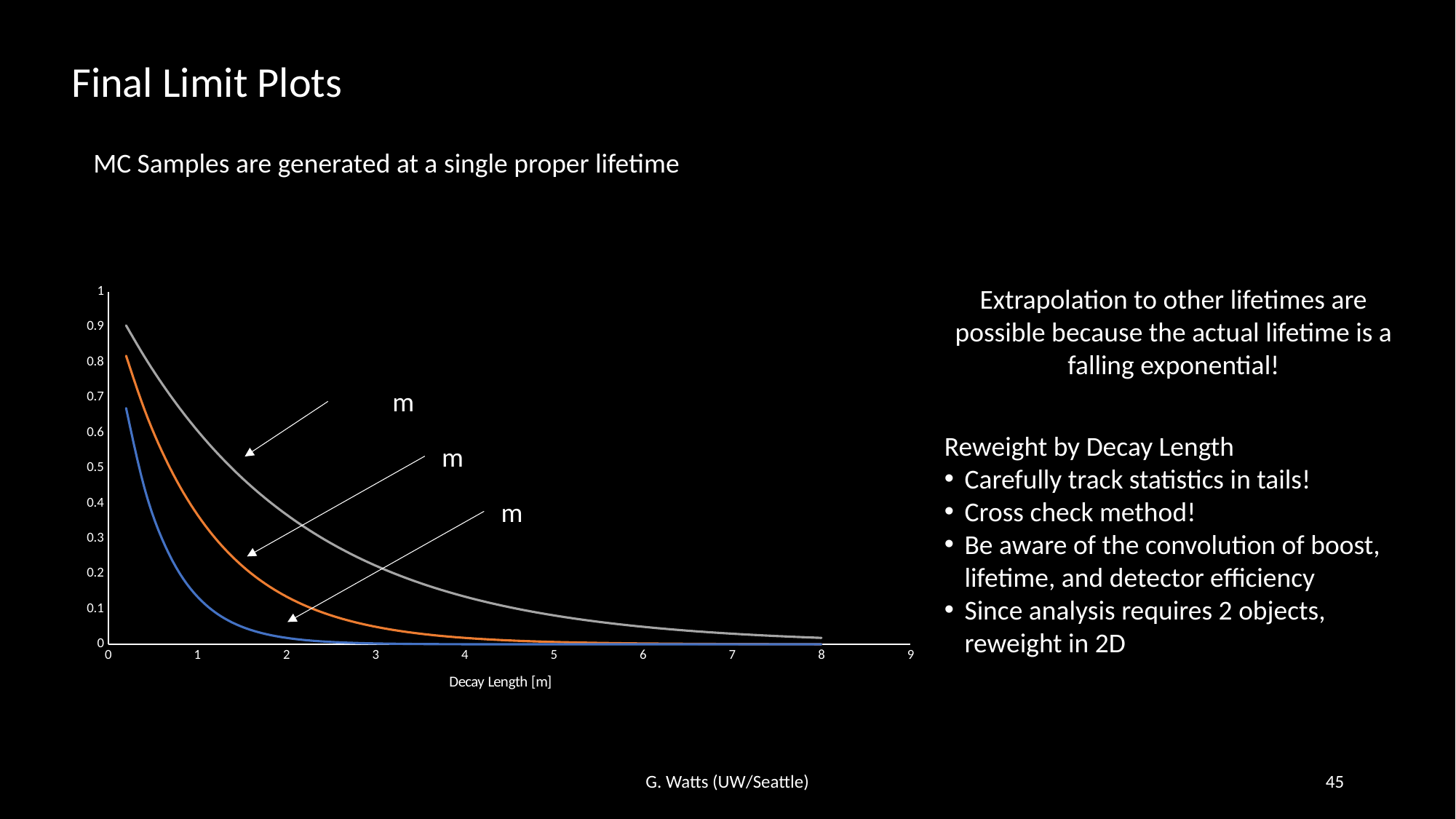
Is the value of the gray curve at a decay length of 1 m greater or less than 0.5? greater Is the value of the blue curve at a decay length of 2 m greater or less than 0.1? less How many curves are plotted on the chart? 3 Which curve is lowest at a decay length of 1 m: the gray, orange or blue one? blue Is the value of the gray curve at a decay length of 6 m greater or less than 0.2? less What kind of chart is shown on the slide? line chart Which curve is highest at a decay length of 1 m: the gray, orange or blue one? gray Do the curves rise or fall as decay length increases? fall At a decay length of 2 m, which curve has the larger value, the orange or the blue one? orange What is the title of the x axis of the chart? Decay Length [m] What is the largest tick value shown on the x axis of the chart? 9